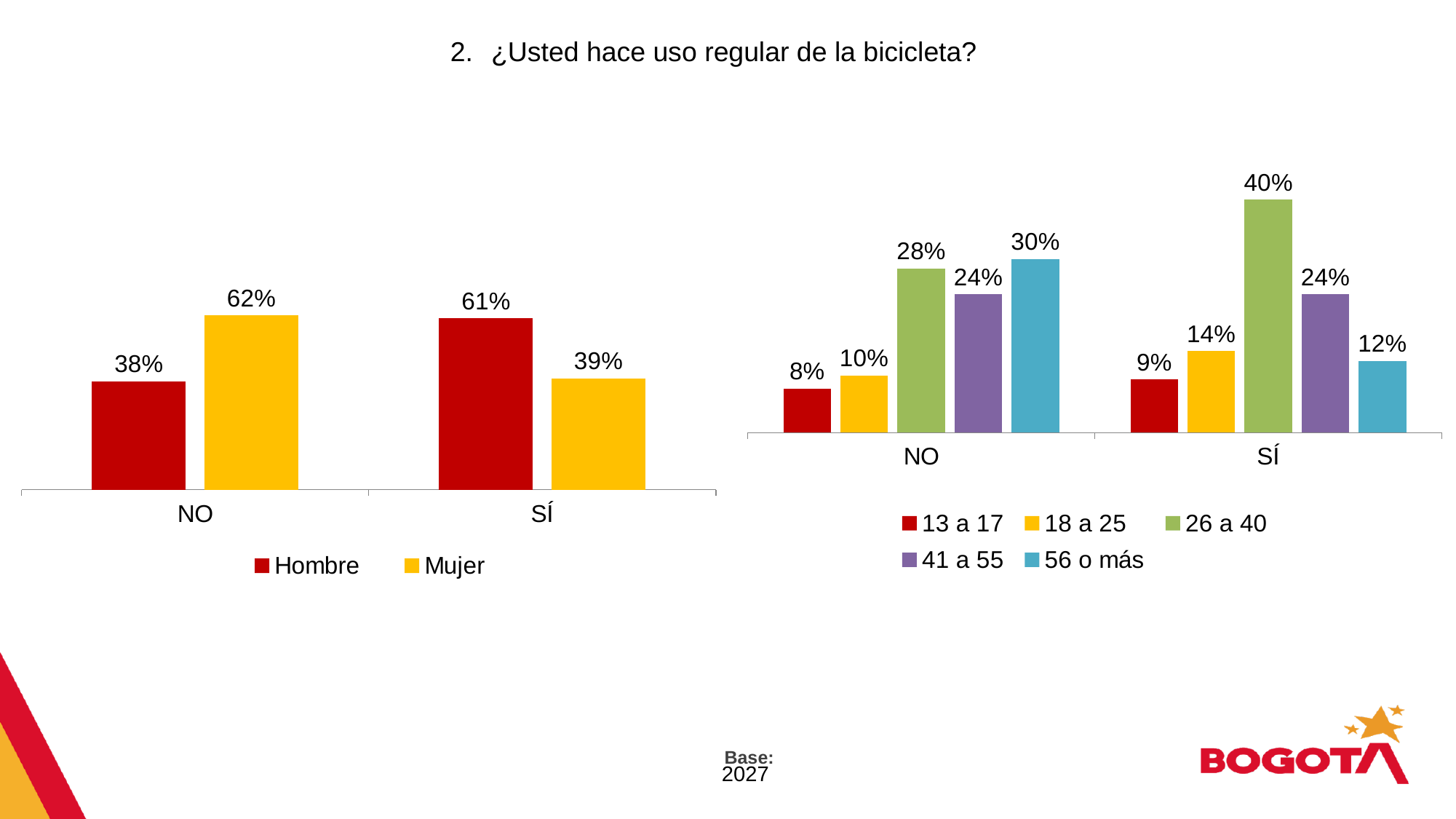
In the left chart, which series is larger in the SÍ category, Hombre or Mujer? Hombre In the right chart, which age group has the highest value in the SÍ category? 26 a 40 In the right chart, how many series does the legend list? 5 In the left chart, what is the difference between Mujer and Hombre in the NO category? 24% What type of chart is the right chart? Bar chart In the left chart, what is the value for Mujer in the NO category? 62% In the right chart, which age group has the lowest value in the NO category? 13 a 17 In the left chart, how many series does the legend list? 2 In the right chart, what is the value for 26 a 40 in the SÍ category? 40% In the right chart, what is the difference between 26 a 40 and 18 a 25 in the SÍ category? 26% In the right chart, what is the value for 56 o más in the NO category? 30% In the left chart, what is the value for Hombre in the SÍ category? 61%